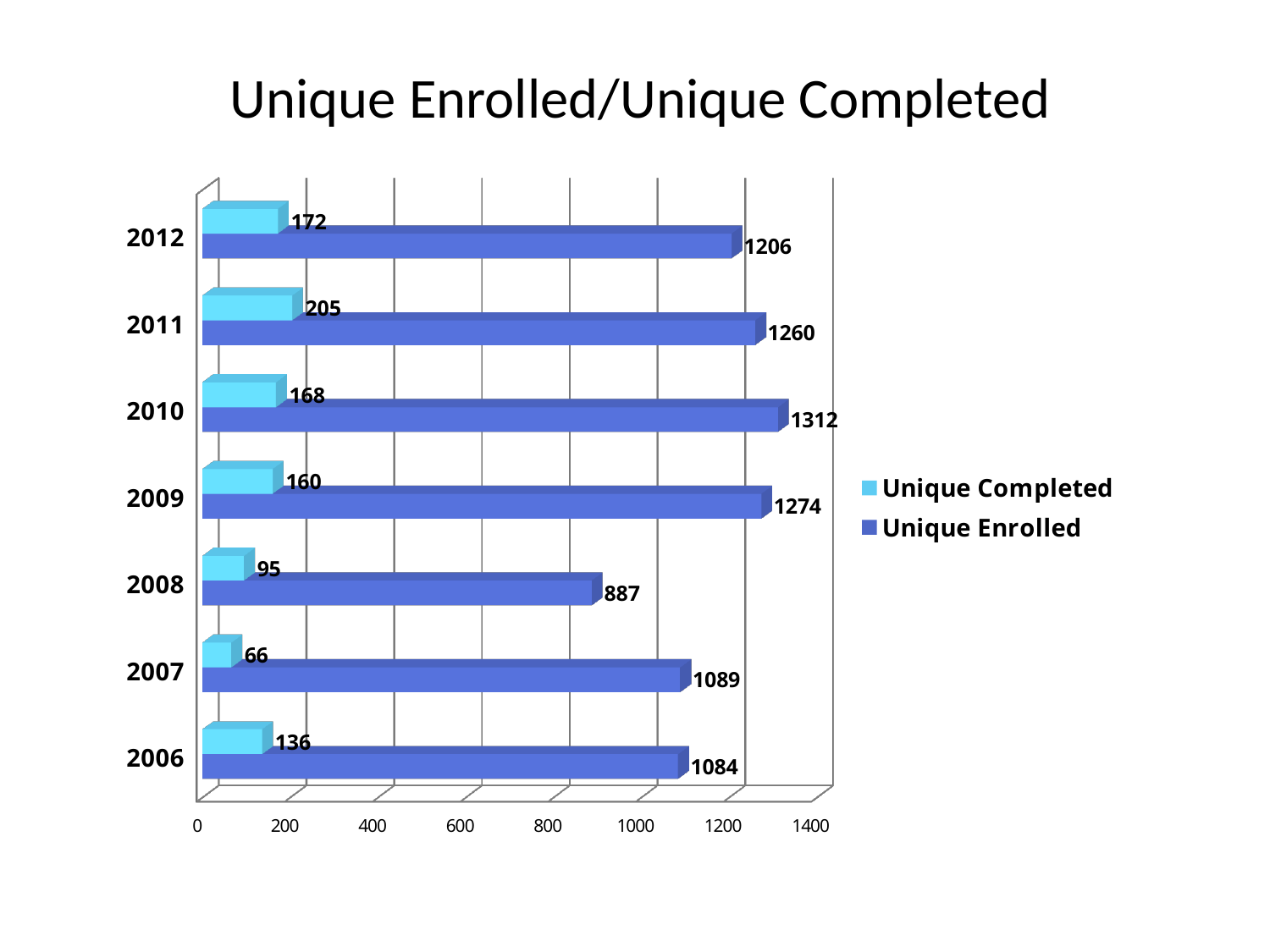
What is the Unique Completed value for 2007? 66 Which year has the highest Unique Enrolled value? 2010 What kind of chart is shown on the slide? bar chart Is the Unique Enrolled value for 2008 greater or less than 1000? less What is the difference between Unique Enrolled and Unique Completed in 2012? 1034 What is the title of the chart? Unique Enrolled/Unique Completed What is the Unique Enrolled value for 2010? 1312 How many series does the legend list? 2 Which is larger, the Unique Completed value for 2011 or for 2009? 2011 How many years are shown on the chart? 7 Which year has the lowest Unique Enrolled value? 2008 Which year has the lowest Unique Completed value? 2007